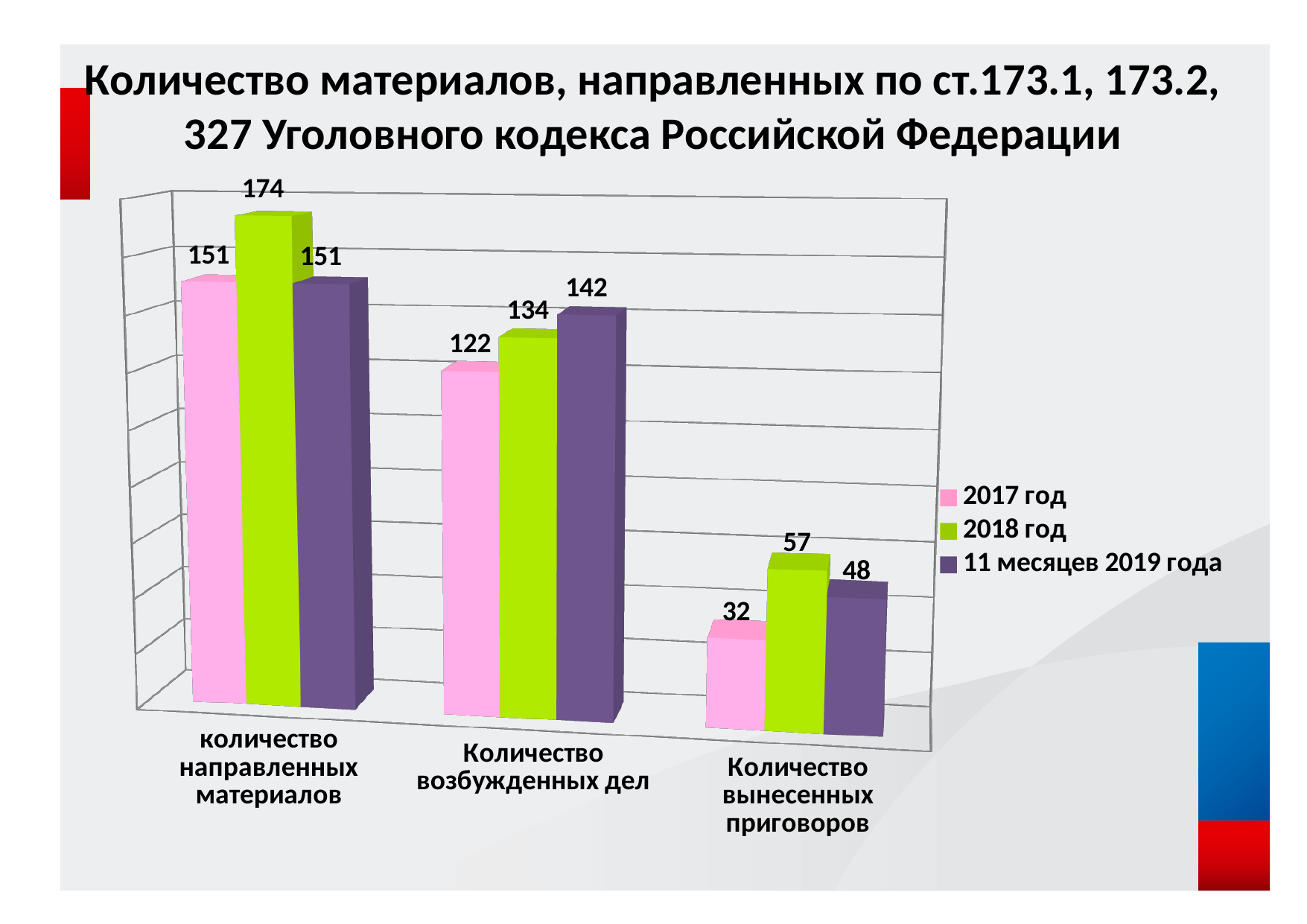
Do the values for 2017 год rise or fall from left to right across the categories? fall What is the value for 11 месяцев 2019 года in the category 'Количество возбужденных дел'? 142 Which category has the lowest value for 2017 год? Количество вынесенных приговоров What is the value for 2018 год in the category 'количество направленных материалов'? 174 Which colour represents the series 2018 год in the legend? green Which is larger in the category 'Количество возбужденных дел': the value for 2018 год or for 11 месяцев 2019 года? 11 месяцев 2019 года How many categories are shown on the x axis? 3 What kind of chart is shown on the slide? bar chart Which series has the highest value in the category 'Количество вынесенных приговоров'? 2018 год What is the difference between the 2018 год and 2017 год values in the category 'количество направленных материалов'? 23 How many series does the legend list? 3 What is the value for 2017 год in the category 'Количество вынесенных приговоров'? 32